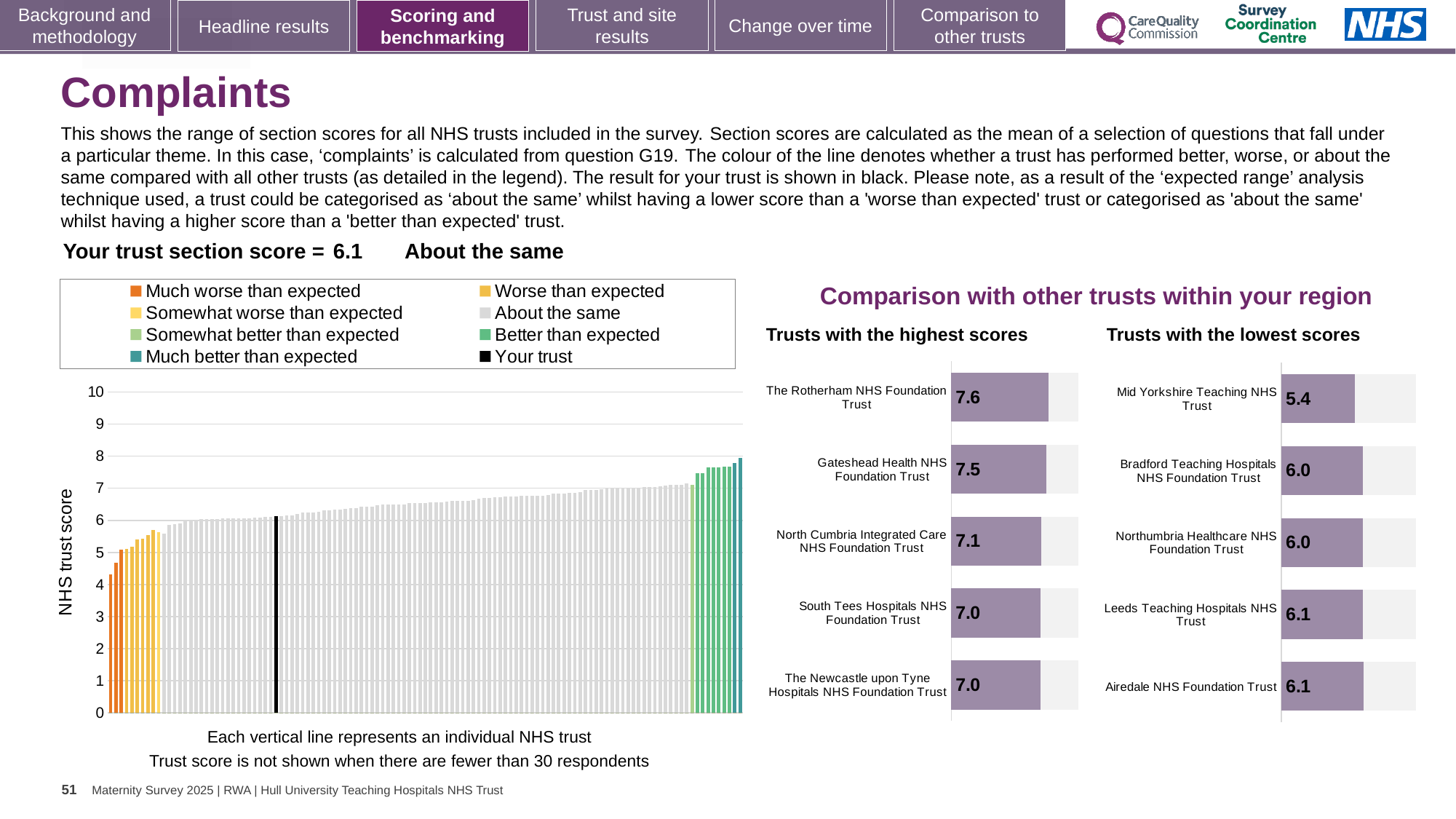
In the 'Trusts with the highest scores' chart, which trust has the highest score? The Rotherham NHS Foundation Trust In the 'Trusts with the lowest scores' chart, what is the difference between the scores of Leeds Teaching Hospitals NHS Trust and Mid Yorkshire Teaching NHS Trust? 0.7 In the 'Trusts with the lowest scores' chart, what is the score for Mid Yorkshire Teaching NHS Trust? 5.4 How many trusts are shown in the 'Trusts with the lowest scores' chart? 5 In the main 'NHS trust score' chart, is the value of the tallest bar greater or less than 7? greater In the main 'NHS trust score' chart, do the bar values rise or fall from left to right? Rise What kind of chart is the main chart on the left with the 'NHS trust score' axis? Bar chart In the 'Trusts with the highest scores' chart, which has the larger score: Gateshead Health NHS Foundation Trust or North Cumbria Integrated Care NHS Foundation Trust? Gateshead Health NHS Foundation Trust In the 'Trusts with the highest scores' chart, what is the score for The Rotherham NHS Foundation Trust? 7.6 In the 'Trusts with the highest scores' chart, what is the difference between the scores of The Rotherham NHS Foundation Trust and Gateshead Health NHS Foundation Trust? 0.1 How many entries does the legend of the main 'NHS trust score' bar chart list? 8 In the 'Trusts with the lowest scores' chart, which trust has the lowest score? Mid Yorkshire Teaching NHS Trust